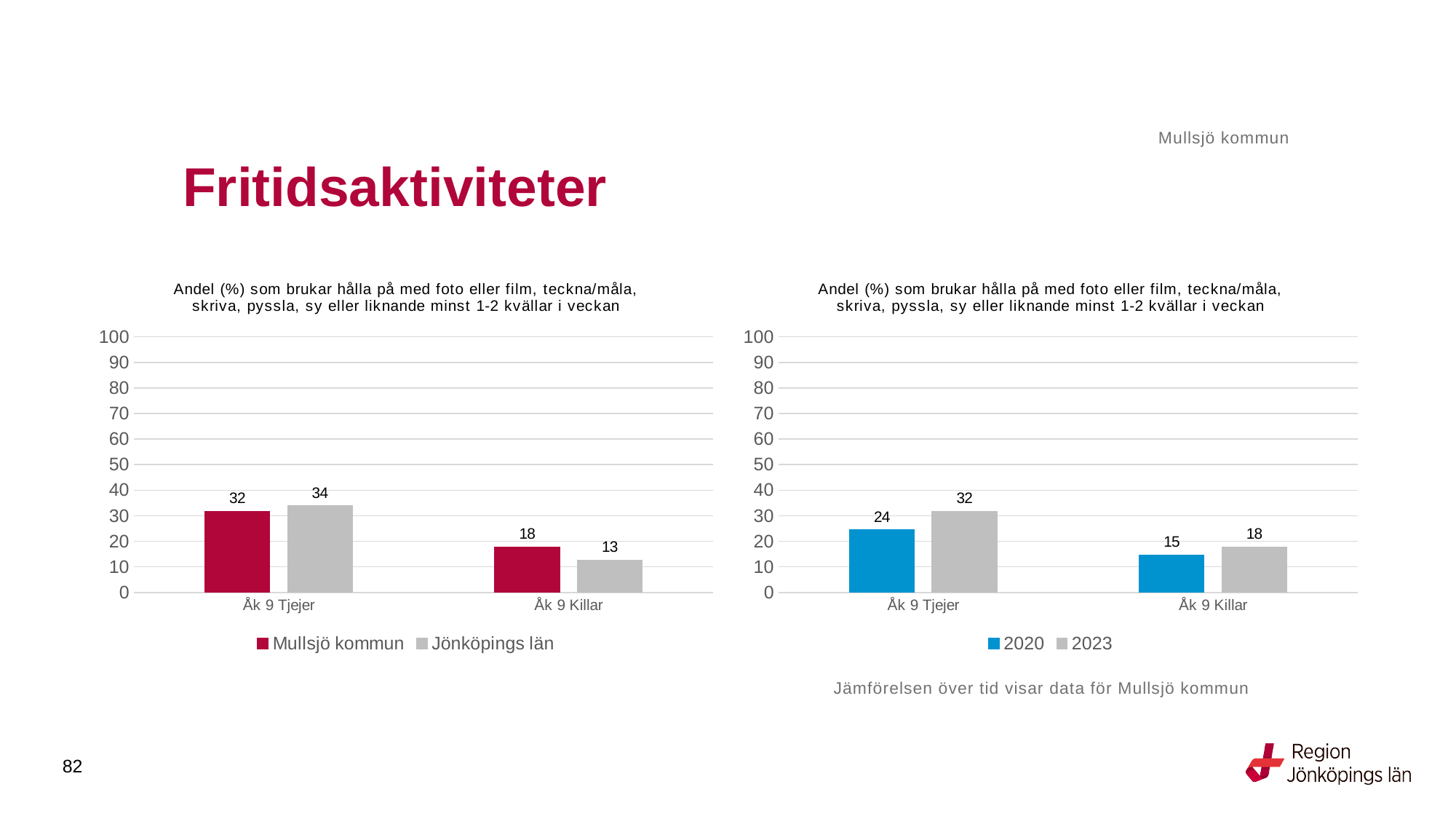
In the left chart, what is the value for Mullsjö kommun for Åk 9 Tjejer? 32 What kind of chart is the left chart? Bar chart In the right chart, which category has the highest value for 2023? Åk 9 Tjejer In the right chart, what is the value for 2023 for Åk 9 Killar? 18 In the right chart, what is the value for 2020 for Åk 9 Tjejer? 24 In the right chart, which bar has the lowest value? 2020 for Åk 9 Killar How many series does the legend of the right chart list? 2 In the right chart, which series is shown in blue? 2020 In the left chart, what is the difference between Mullsjö kommun and Jönköpings län for Åk 9 Killar? 5 In the right chart, what is the difference between 2023 and 2020 for Åk 9 Tjejer? 8 In the left chart, what is the value for Jönköpings län for Åk 9 Killar? 13 In the left chart, which is larger for Åk 9 Tjejer: Mullsjö kommun or Jönköpings län? Jönköpings län